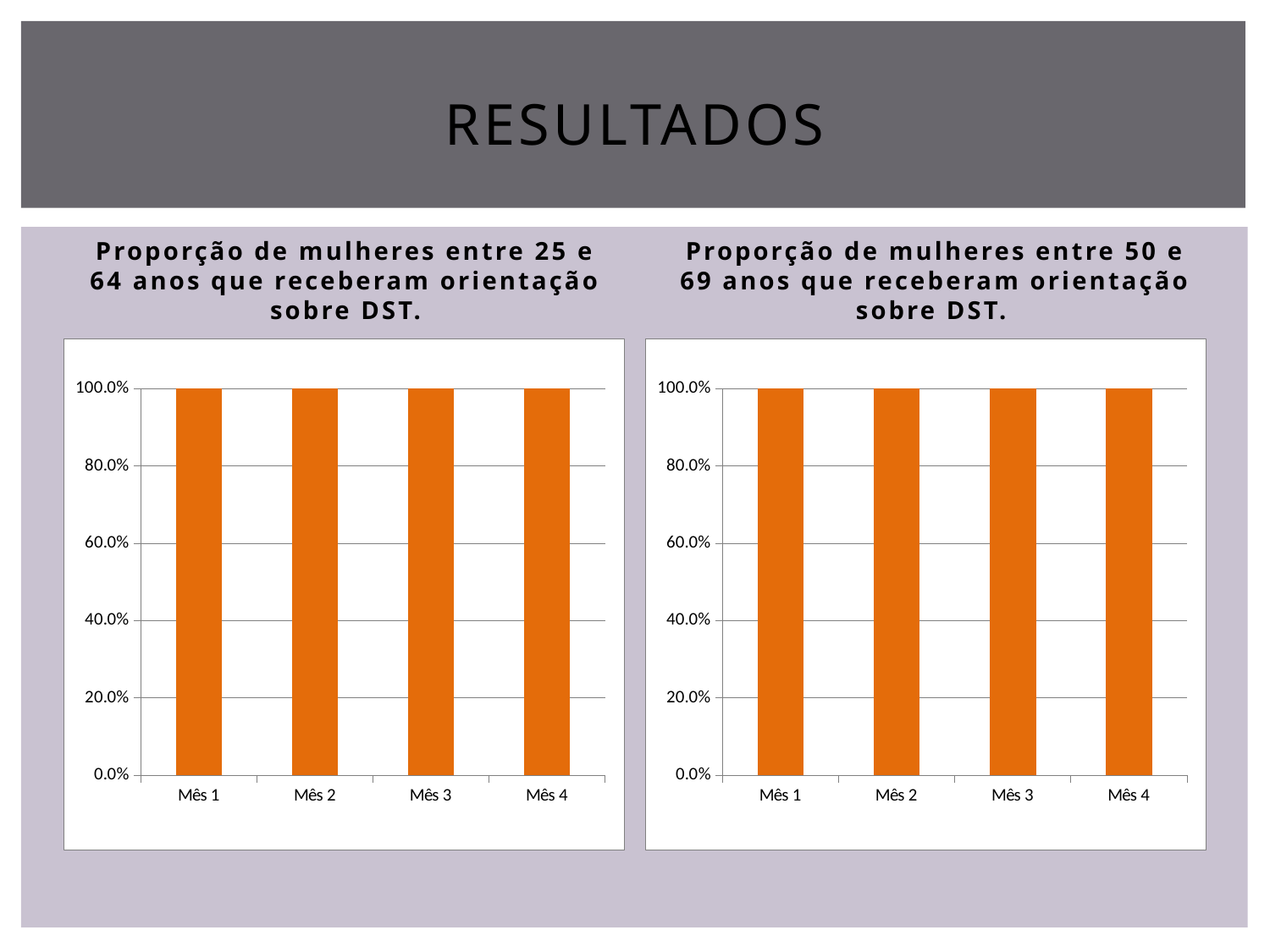
In the left chart (Proporção de mulheres entre 25 e 64 anos), what is the value for Mês 3? 100.0% How many categories are shown on the x axis of the left chart (Proporção de mulheres entre 25 e 64 anos)? 4 In the right chart (Proporção de mulheres entre 50 e 69 anos), is the value for Mês 3 greater or less than 80.0%? greater How many bars are plotted in the right chart (Proporção de mulheres entre 50 e 69 anos)? 4 In the left chart (Proporção de mulheres entre 25 e 64 anos), what is the difference between the values for Mês 2 and Mês 4? 0.0% What kind of chart is the left chart (Proporção de mulheres entre 25 e 64 anos)? Bar chart What is the title of the right chart on the slide? Proporção de mulheres entre 50 e 69 anos que receberam orientação sobre DST. What kind of chart is the right chart (Proporção de mulheres entre 50 e 69 anos)? Bar chart In the right chart (Proporção de mulheres entre 50 e 69 anos), what is the value for Mês 2? 100.0% In the left chart (Proporção de mulheres entre 25 e 64 anos), do the values rise, fall, or stay the same from Mês 1 to Mês 4? Stay the same In the right chart (Proporção de mulheres entre 50 e 69 anos), what is the value for Mês 4? 100.0% In the left chart (Proporção de mulheres entre 25 e 64 anos), what is the value for Mês 1? 100.0%